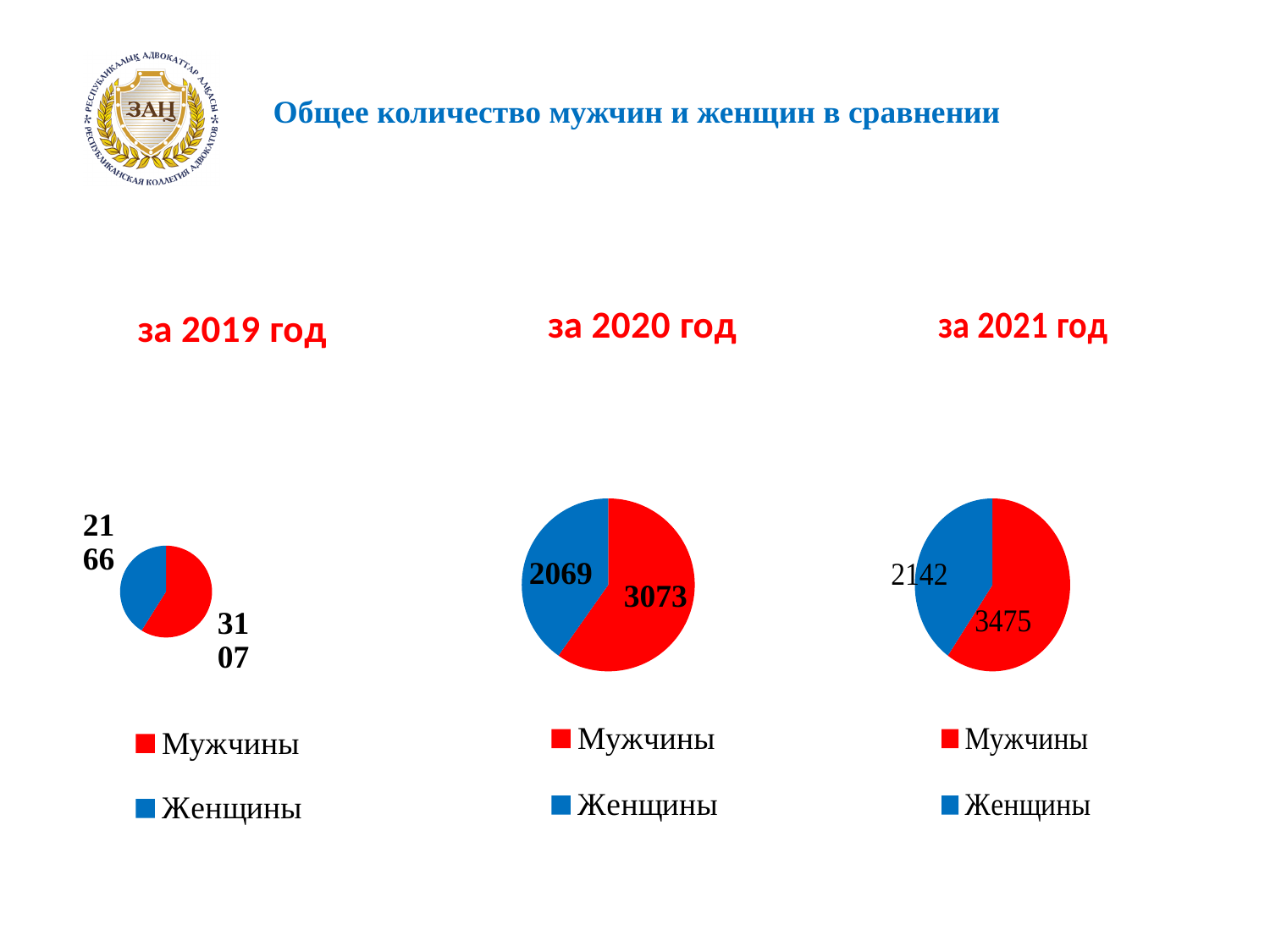
What kind of chart is used for 2019 (за 2019 год)? pie chart In the chart for 2020 (за 2020 год), what is the value for Женщины? 2069 In the chart for 2019 (за 2019 год), what is the value for Мужчины? 3107 In the chart for 2021 (за 2021 год), what is the difference between the values for Мужчины and Женщины? 1333 In the chart for 2020 (за 2020 год), what is the value for Мужчины? 3073 How many charts are shown on the slide? 3 How many entries does the legend of the chart for 2021 (за 2021 год) list? 2 In the chart for 2021 (за 2021 год), what is the value for Женщины? 2142 In the chart for 2020 (за 2020 год), what colour represents Женщины? blue In the chart for 2019 (за 2019 год), what is the value for Женщины? 2166 In the chart for 2020 (за 2020 год), which category is larger, Мужчины or Женщины? Мужчины In the chart for 2021 (за 2021 год), what is the value for Мужчины? 3475